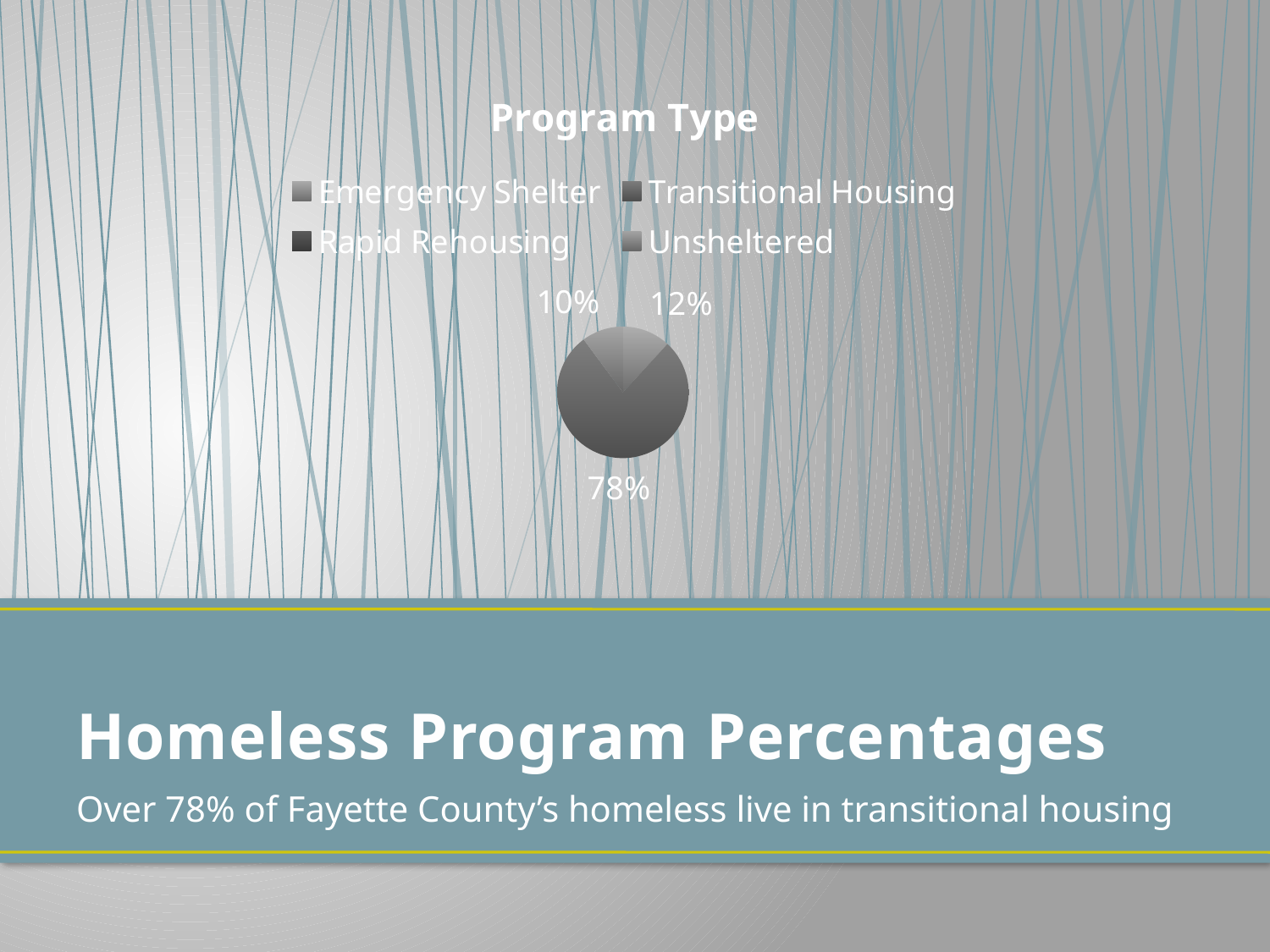
Which legend entry is listed first in the chart's legend? Emergency Shelter Which program type has the largest share of the pie? Transitional Housing What share of the pie does Transitional Housing represent? 78% What kind of chart is shown on the slide? pie chart What is the difference between the 12% slice and the 10% slice? 2% How many categories does the chart's legend list? 4 What is the largest percentage labelled on the pie chart? 78% How many percentage labels are shown on the pie chart? 3 What is the title of the chart? Program Type What is the smallest percentage labelled on the pie chart? 10% Is the share for Transitional Housing greater or less than 50%? greater What is the difference between the largest and smallest percentages labelled on the pie chart? 68%